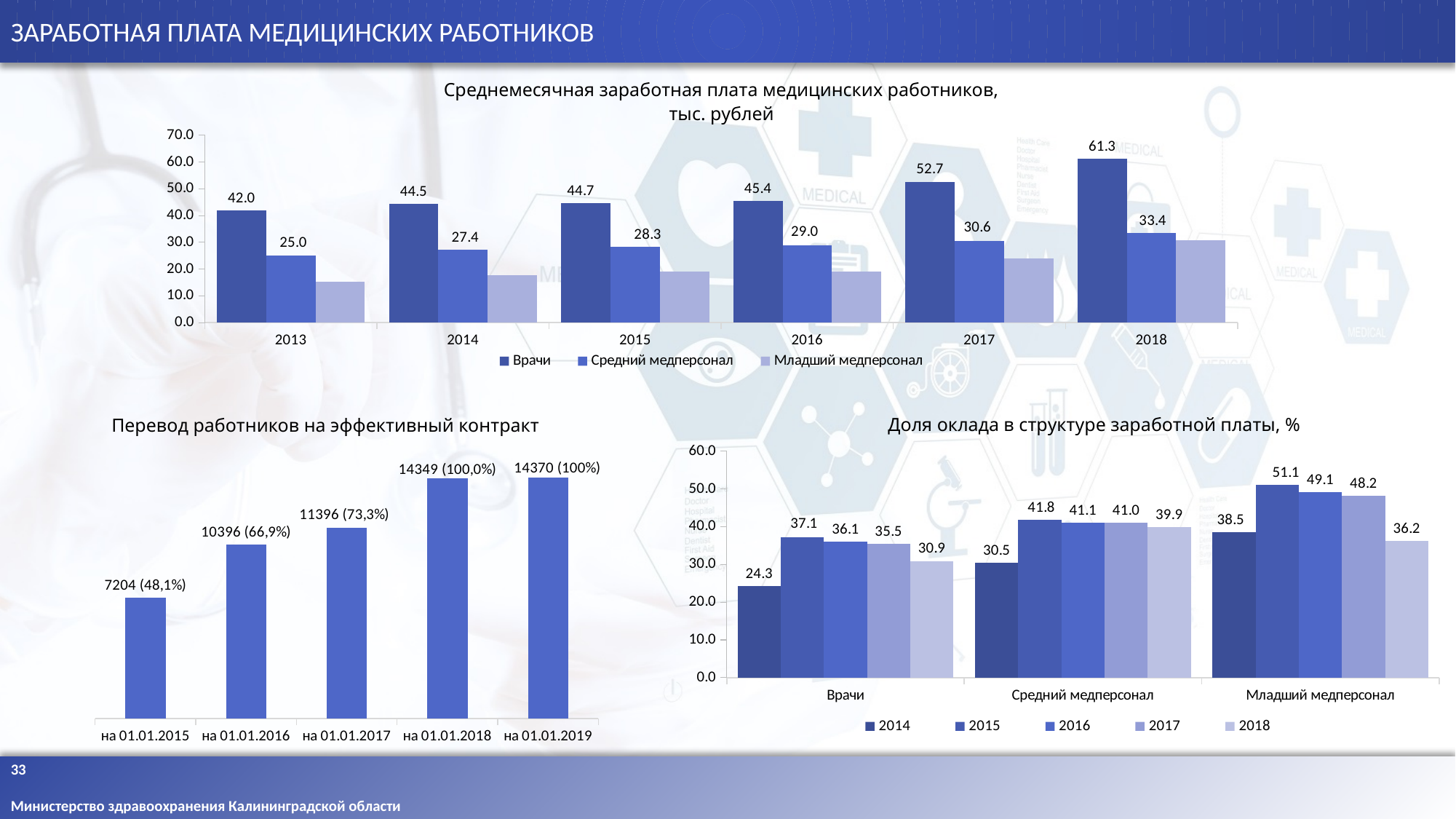
In the chart 'Перевод работников на эффективный контракт', which category has the lowest value? на 01.01.2015 In the chart 'Перевод работников на эффективный контракт', what is the data label for на 01.01.2016? 10396 (66,9%) In the chart 'Среднемесячная заработная плата медицинских работников, тыс. рублей', what is the difference between Врачи and Средний медперсонал in 2017? 22.1 In the chart 'Доля оклада в структуре заработной платы, %', what is the value for Младший медперсонал in 2015? 51.1 What kind of chart is 'Доля оклада в структуре заработной платы, %'? bar chart In the chart 'Среднемесячная заработная плата медицинских работников, тыс. рублей', is the value for Младший медперсонал in 2013 greater or less than 20.0? less How many categories are shown in the chart 'Перевод работников на эффективный контракт'? 5 In the chart 'Доля оклада в структуре заработной платы, %', which is larger for Врачи: the 2014 value or the 2018 value? 2018 In the chart 'Среднемесячная заработная плата медицинских работников, тыс. рублей', what is the value for Средний медперсонал in 2015? 28.3 In the chart 'Среднемесячная заработная плата медицинских работников, тыс. рублей', what is the value for Врачи in 2018? 61.3 How many series does the legend of the chart 'Среднемесячная заработная плата медицинских работников, тыс. рублей' list? 3 In the chart 'Среднемесячная заработная плата медицинских работников, тыс. рублей', do the values for Врачи rise or fall from 2013 to 2018? rise